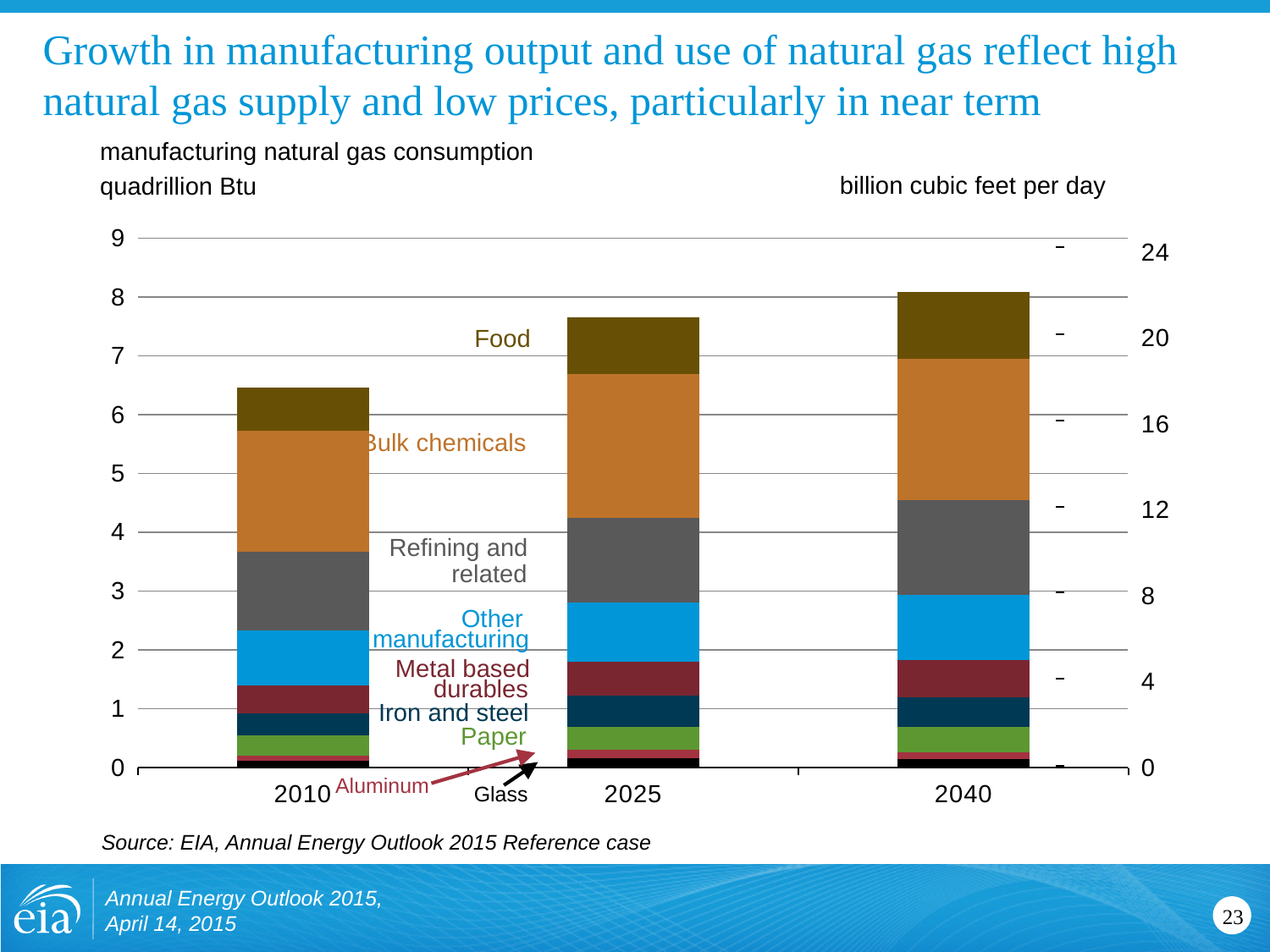
How many years (bars) are plotted in the chart? 3 What kind of chart is shown on the slide? stacked bar chart Is the total for 2040 greater or less than 9 quadrillion Btu? less Is the total for 2025 greater or less than 7 quadrillion Btu? greater Which sector segment is the largest in the 2010 bar? Bulk chemicals Which year has the highest total manufacturing natural gas consumption? 2040 Which year has the lowest total manufacturing natural gas consumption? 2010 What unit is shown on the left vertical axis? quadrillion Btu What unit is shown on the right vertical axis? billion cubic feet per day Which is larger, the total for 2025 or the total for 2010? 2025 Is the total for 2010 greater or less than 6 quadrillion Btu? greater Does total manufacturing natural gas consumption rise or fall from 2010 to 2040? rise